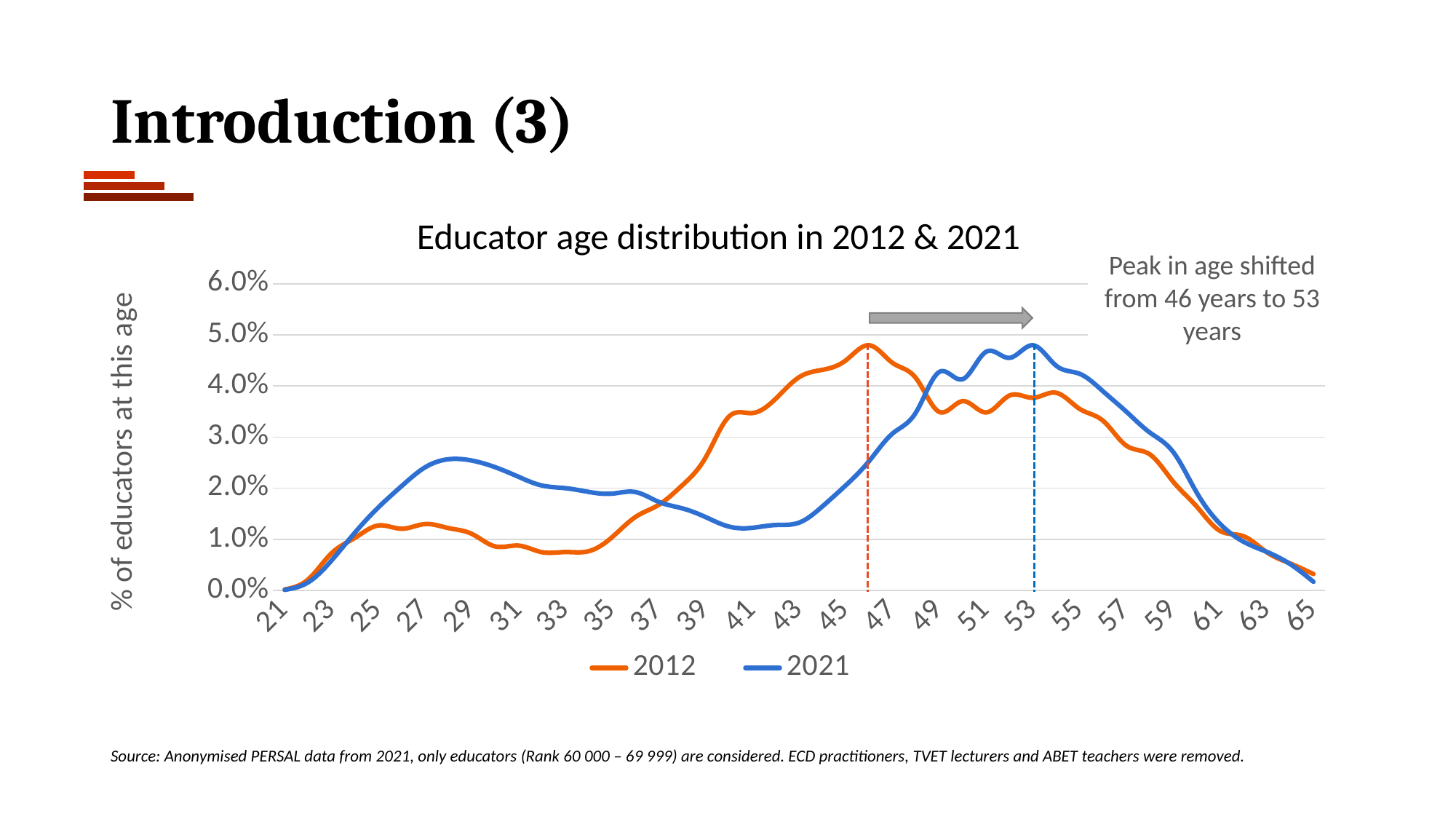
Is the value for 2012 at age 41 greater or less than 3.0%? greater At age 29, which series has the larger value, 2012 or 2021? 2021 At age 41, which series has the larger value, 2012 or 2021? 2012 How many series does the legend list? 2 At which age does the 2021 series reach its peak? 53 years What kind of chart is shown on the slide? Line chart What is the title of the chart? Educator age distribution in 2012 & 2021 Is the value for 2012 at age 33 greater or less than 1.0%? less What is the label on the vertical axis of the chart? % of educators at this age At which age does the 2012 series reach its peak? 46 years Is the value for 2021 at age 41 greater or less than 2.0%? less